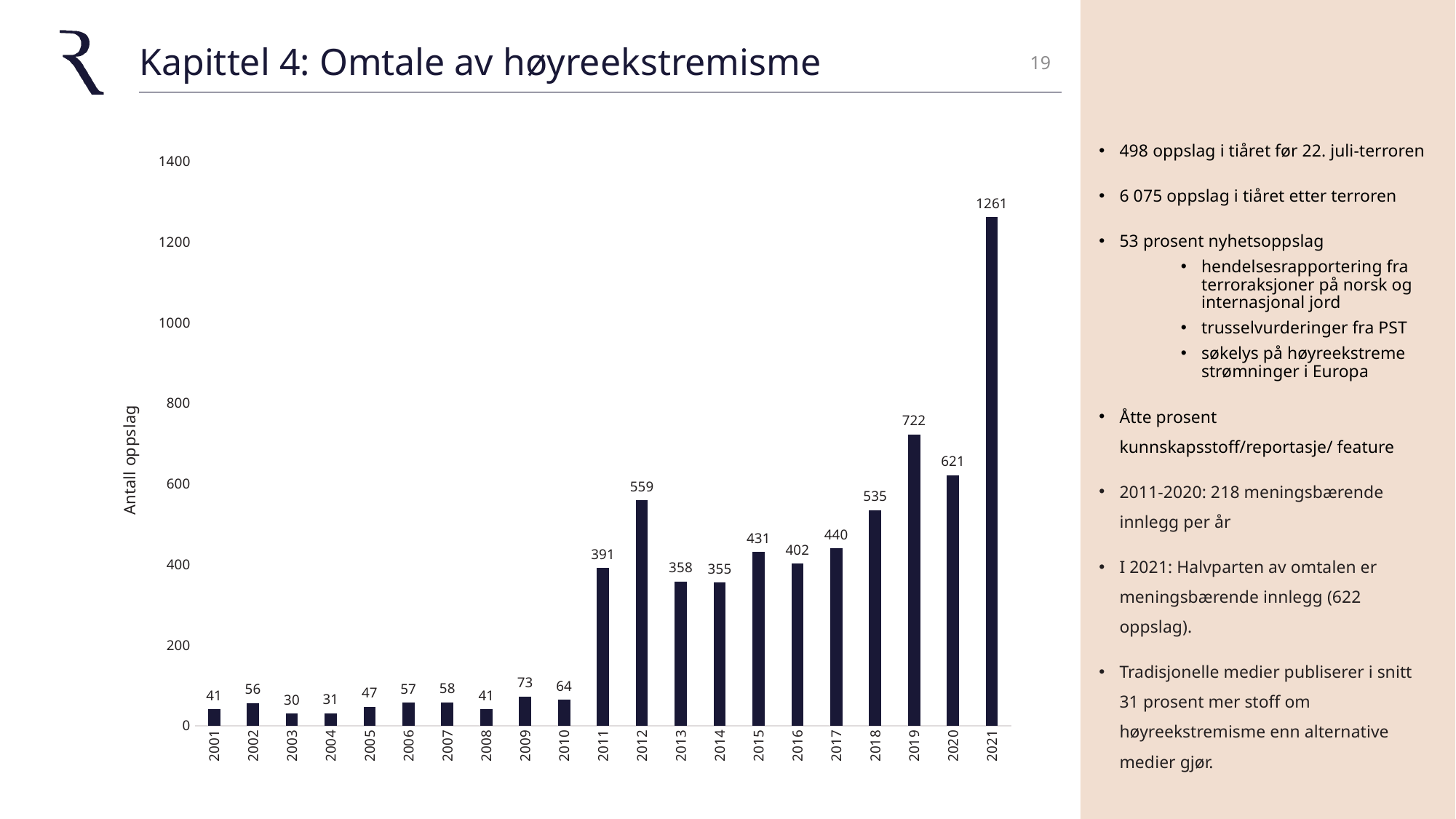
Which year has the highest value? 2021 Is the value for 2019 greater or less than 600? greater What kind of chart is shown on the slide? bar chart Which is larger, the value for 2012 or the value for 2018? 2012 Do the values generally rise or fall from 2010 to 2012? rise How many years are shown on the x axis? 21 What is the difference between the values for 2021 and 2020? 640 What is the value for 2003? 30 What is the label of the y axis? Antall oppslag Which year has the lowest value? 2003 What is the value for 2011? 391 What is the value for 2021? 1261